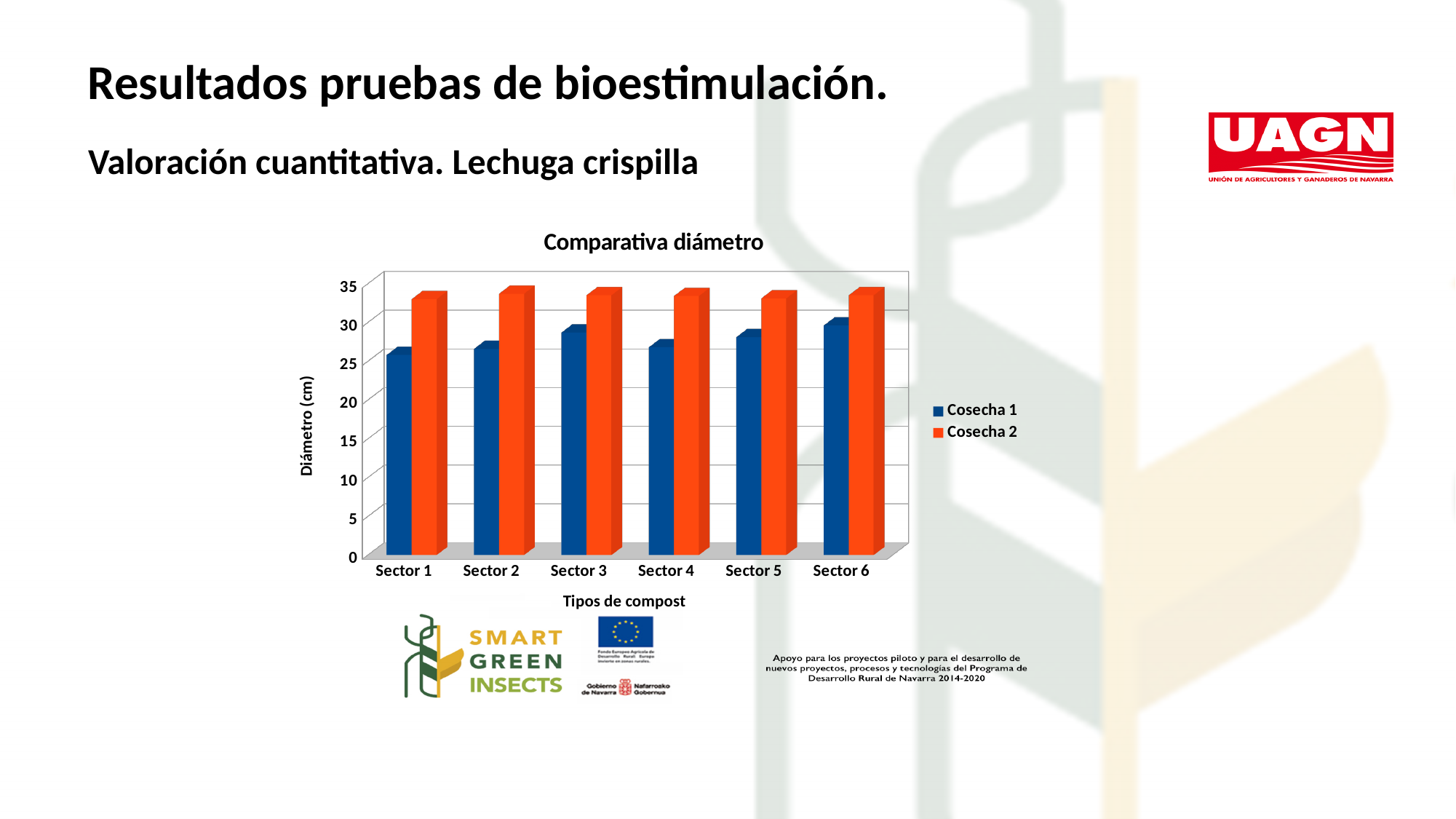
What is the title of the chart? Comparativa diámetro Is the Cosecha 1 value for Sector 1 greater or less than 30? less What is the label of the vertical axis of the chart? Diámetro (cm) Is the Cosecha 2 value for Sector 2 greater or less than 35? less For Cosecha 1, which is larger, Sector 1 or Sector 6? Sector 6 How many sectors are shown on the x axis of the chart? 6 Is the Cosecha 1 value for Sector 6 greater or less than 25? greater How many series does the chart legend list? 2 For Sector 3, which series has the larger value, Cosecha 1 or Cosecha 2? Cosecha 2 Which sector has the highest Cosecha 1 value? Sector 6 What type of chart is shown on the slide? Bar chart